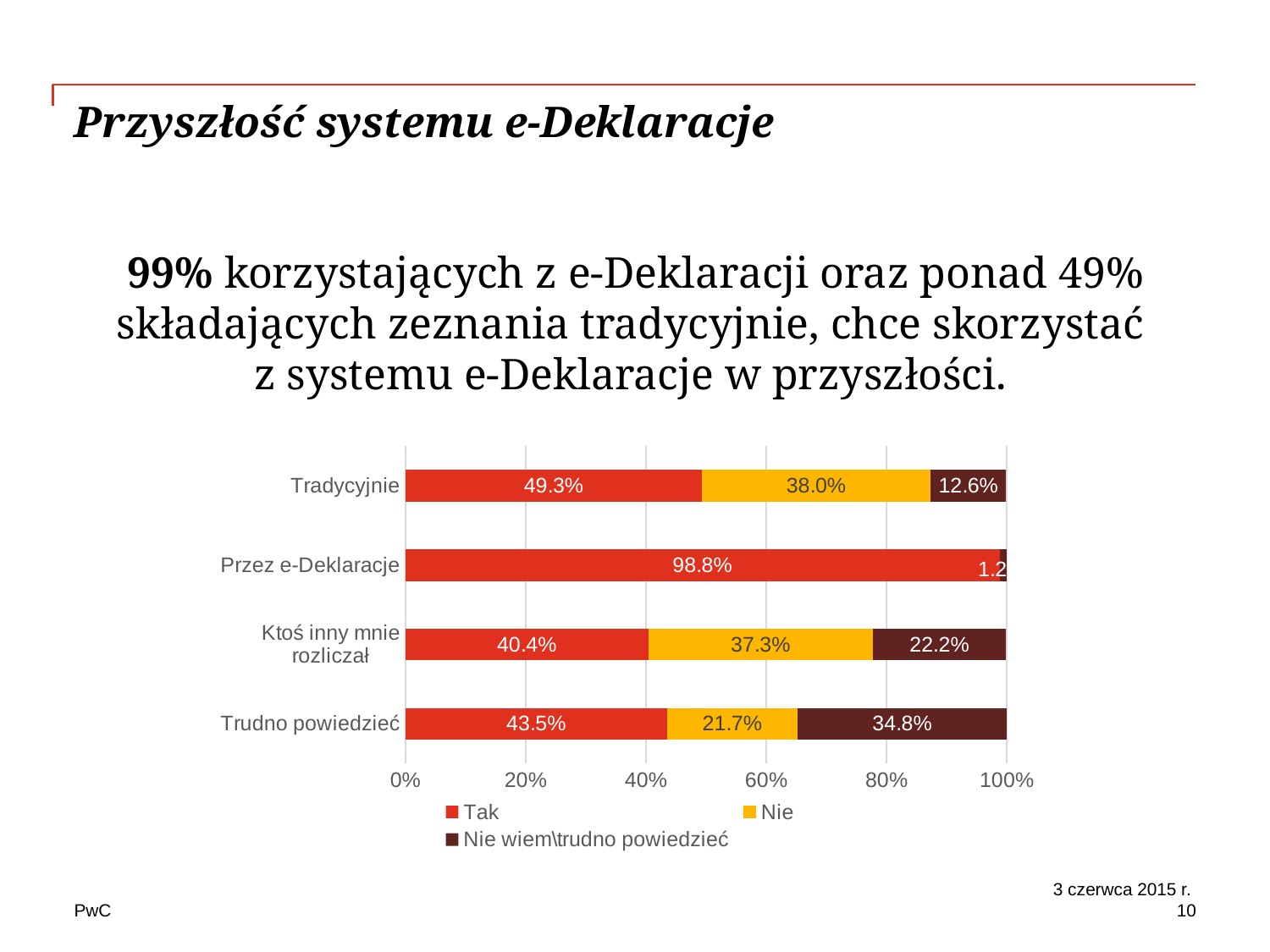
Which category has the highest 'Tak' value? Przez e-Deklaracje What is the 'Nie wiem\trudno powiedzieć' value for 'Ktoś inny mnie rozliczał'? 22.2% What is the 'Tak' value for 'Trudno powiedzieć'? 43.5% What is the 'Tak' value for 'Przez e-Deklaracje'? 98.8% Which is larger: the 'Nie wiem\trudno powiedzieć' value for 'Trudno powiedzieć' or for 'Tradycyjnie'? Trudno powiedzieć Which series is shown in yellow in the chart? Nie How many categories are shown on the vertical axis of the chart? 4 Which category has the lowest 'Tak' value? Ktoś inny mnie rozliczał What is the 'Nie' value for 'Tradycyjnie'? 38.0% What kind of chart is shown on the slide? stacked bar chart What is the difference between the 'Nie' values for 'Tradycyjnie' and 'Trudno powiedzieć'? 16.3% How many series does the chart legend list? 3